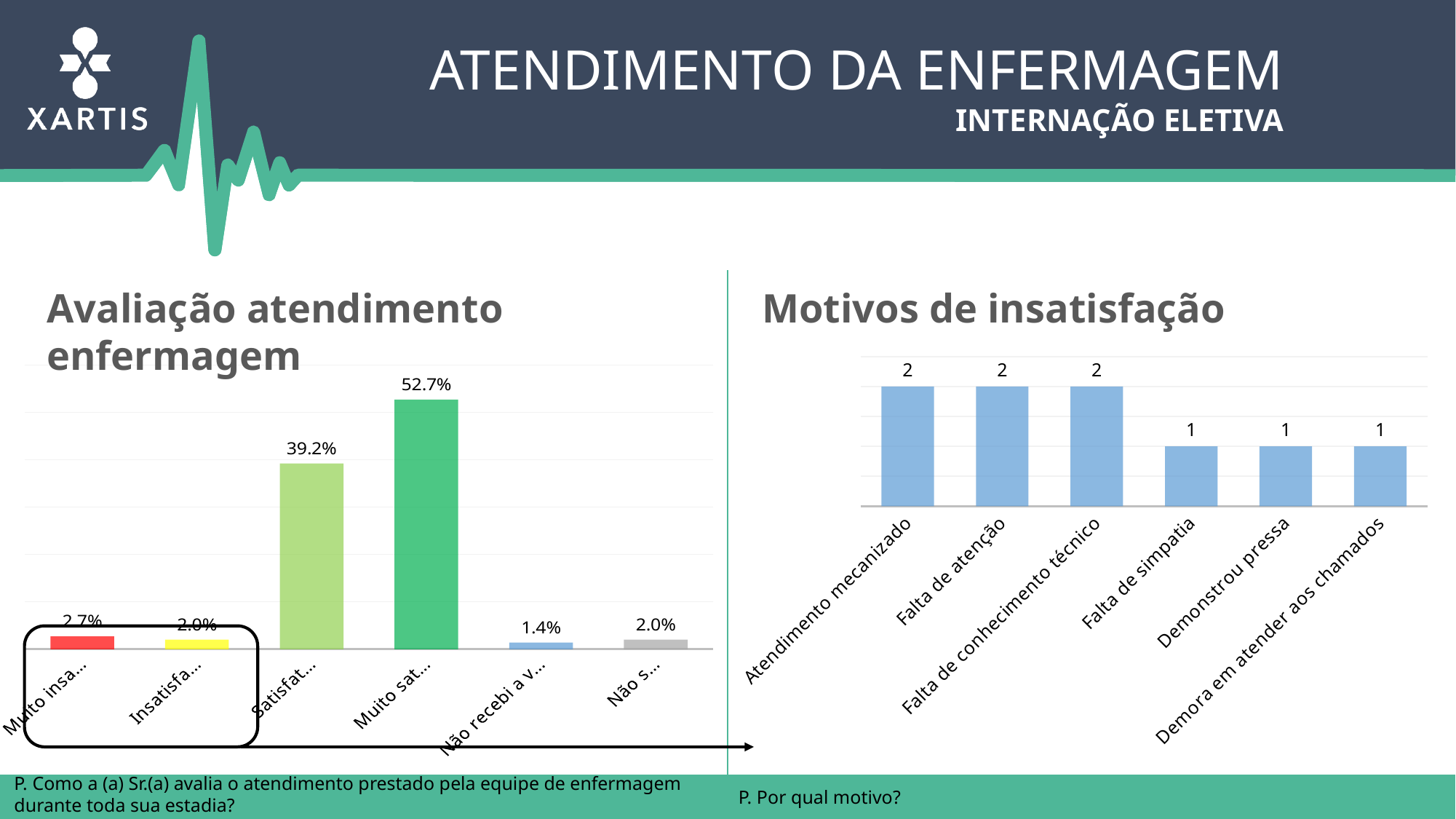
In the 'Avaliação atendimento enfermagem' chart, what is the value of the bar labelled 'Satisfat...'? 39.2% In the 'Motivos de insatisfação' chart, which is larger: 'Atendimento mecanizado' or 'Demonstrou pressa'? Atendimento mecanizado In the 'Motivos de insatisfação' chart, how many categories are shown? 6 What type of chart is the 'Motivos de insatisfação' chart? Bar chart In the 'Motivos de insatisfação' chart, what is the value for 'Falta de simpatia'? 1 In the 'Avaliação atendimento enfermagem' chart, how many bars are plotted? 6 In the 'Avaliação atendimento enfermagem' chart, what is the value of the bar labelled 'Muito sat...'? 52.7% In the 'Avaliação atendimento enfermagem' chart, which category has the highest value? Muito sat... In the 'Avaliação atendimento enfermagem' chart, what is the difference between the 'Muito sat...' and 'Satisfat...' values? 13.5% In the 'Avaliação atendimento enfermagem' chart, what is the value of the bar labelled 'Não recebi a v...'? 1.4% In the 'Avaliação atendimento enfermagem' chart, which category has the lowest value? Não recebi a v... In the 'Motivos de insatisfação' chart, what is the value for 'Falta de atenção'? 2